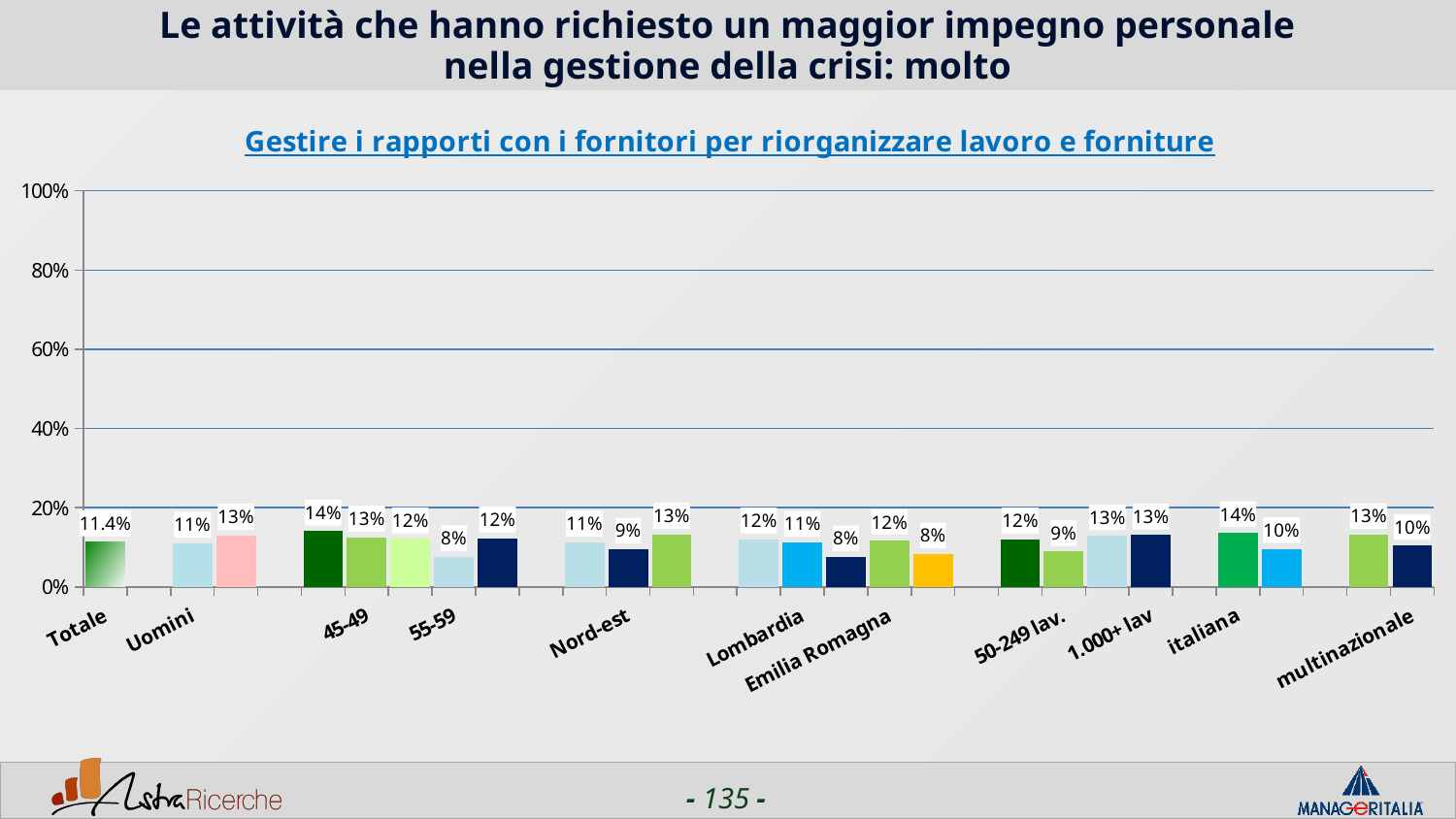
What is the value for multinazionale? 10% Is the value for italiana greater or less than 20%? less Is the value for Totale greater or less than 20%? less What is the subtitle of the chart? Gestire i rapporti con i fornitori per riorganizzare lavoro e forniture Which is larger, the value for Totale or the value for 55-59? Totale What kind of chart is shown on the slide? bar chart What is the highest value shown on the vertical axis? 100% What is the value for Totale? 11.4% What is the value for 55-59? 8% What is the value for italiana? 14% What is the value for Uomini? 11% What is the difference between the value for italiana and the value for multinazionale? 4%